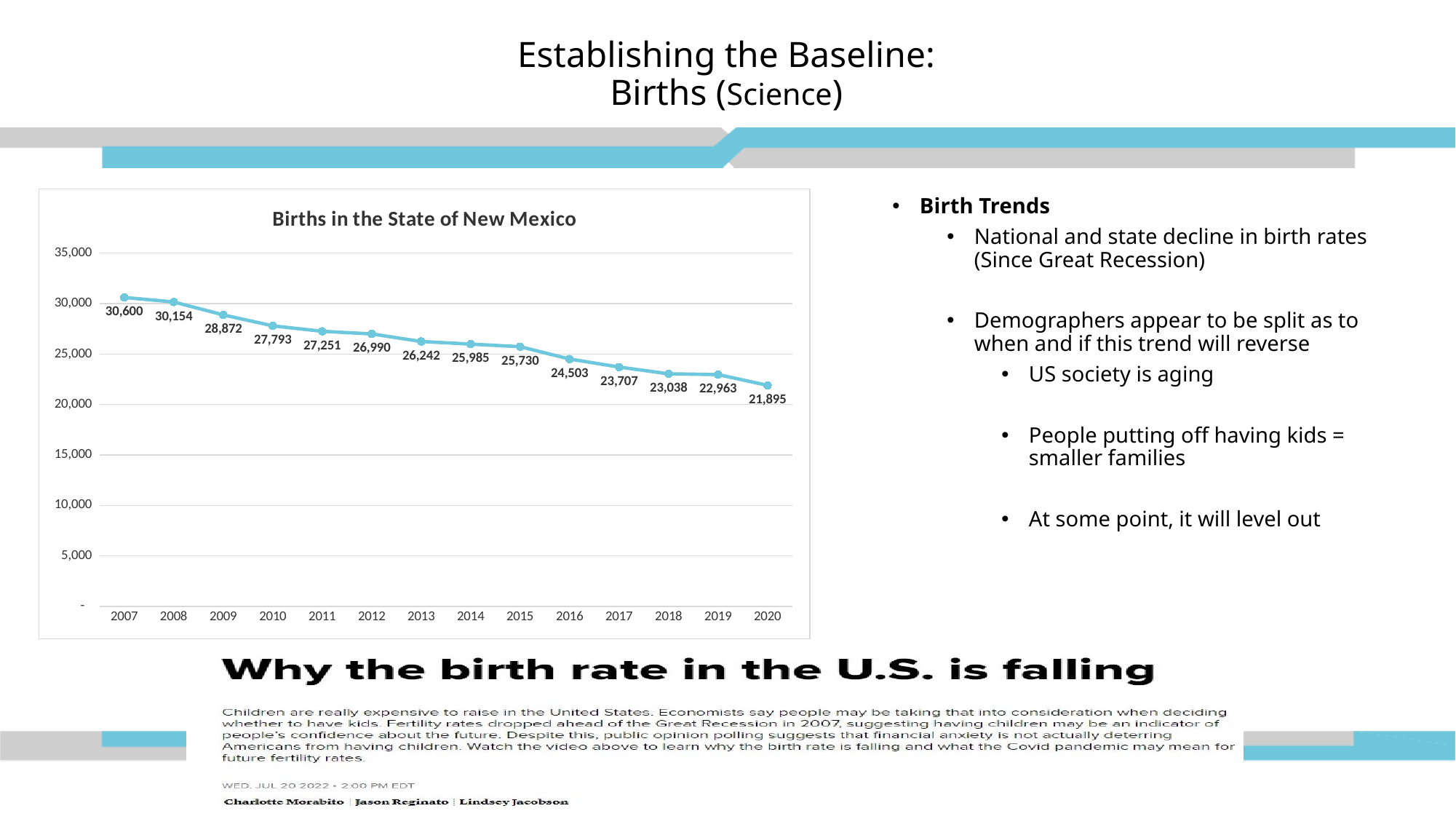
Which year had more births, 2010 or 2015? 2010 Which year has the lowest number of births in the chart? 2020 What is the number of births in New Mexico in 2020? 21,895 Which year has the highest number of births in the chart? 2007 What is the difference in births between 2007 and 2020? 8,705 What is the number of births in New Mexico in 2013? 26,242 What is the number of births in New Mexico in 2007? 30,600 What kind of chart is used to show births in New Mexico? line chart How many years are plotted on the x axis of the chart? 14 Do births in New Mexico rise or fall from 2007 to 2020? fall Is the value for 2016 greater or less than 25,000? less What is the title of the chart? Births in the State of New Mexico